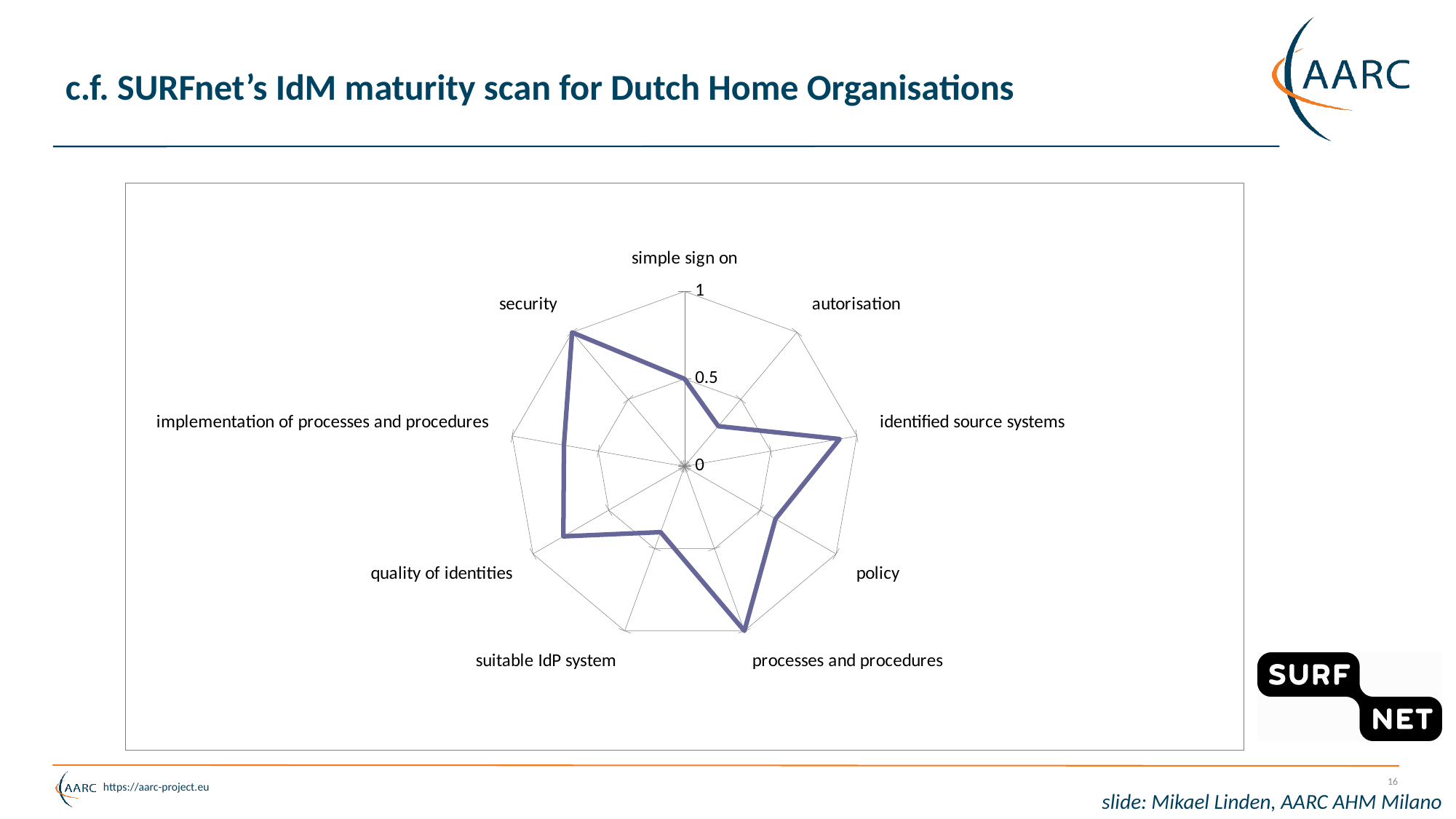
What is the maximum value shown on the radar chart's scale? 1 Which has the larger value, security or autorisation? security Is the value for identified source systems greater or less than 0.5? greater Is the value for security greater or less than 0.5? greater Which category has the highest value on the radar chart? processes and procedures and security (tied at 1) Which category has the lowest value on the radar chart? autorisation Is the value for autorisation greater or less than 0.5? less Which has the larger value, suitable IdP system or identified source systems? identified source systems How many categories (axes) does the radar chart have? 9 What kind of chart is shown on the slide? radar chart